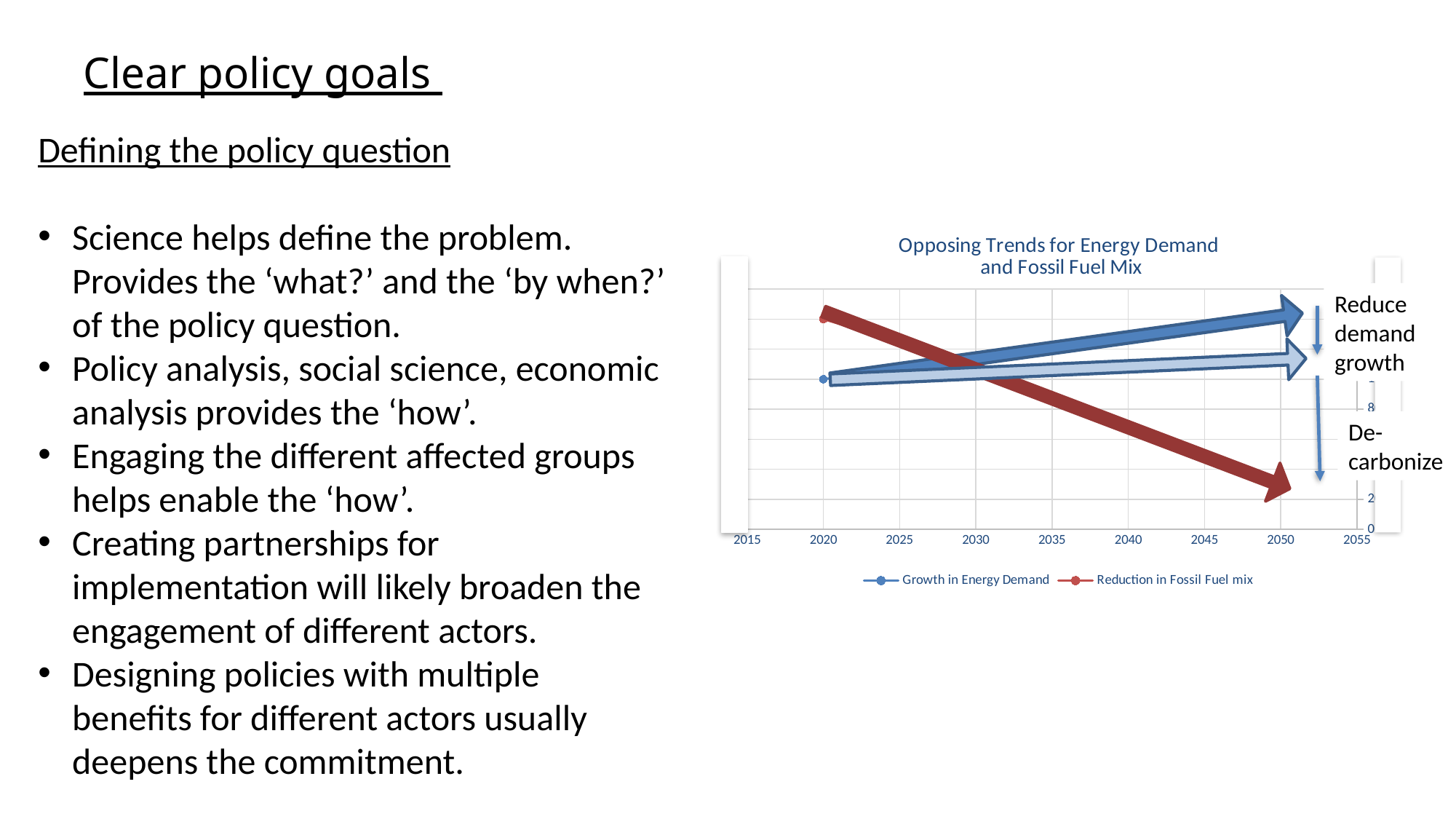
What is the title of the chart? Opposing Trends for Energy Demand and Fossil Fuel Mix Does the Growth in Energy Demand series rise or fall from 2020 to 2050? Rises What are the two series named in the legend? Growth in Energy Demand; Reduction in Fossil Fuel mix How many series does the chart's legend list? 2 Which series is drawn in red? Reduction in Fossil Fuel mix What is the last year label shown on the x axis? 2055 What kind of chart is shown on the slide? Line chart How many year labels are shown on the x axis? 9 In 2050, which series has the higher value: Growth in Energy Demand or Reduction in Fossil Fuel mix? Growth in Energy Demand What is the first year label shown on the x axis? 2015 In 2020, which series has the higher value: Growth in Energy Demand or Reduction in Fossil Fuel mix? Reduction in Fossil Fuel mix Does the Reduction in Fossil Fuel mix series rise or fall from 2020 to 2050? Falls